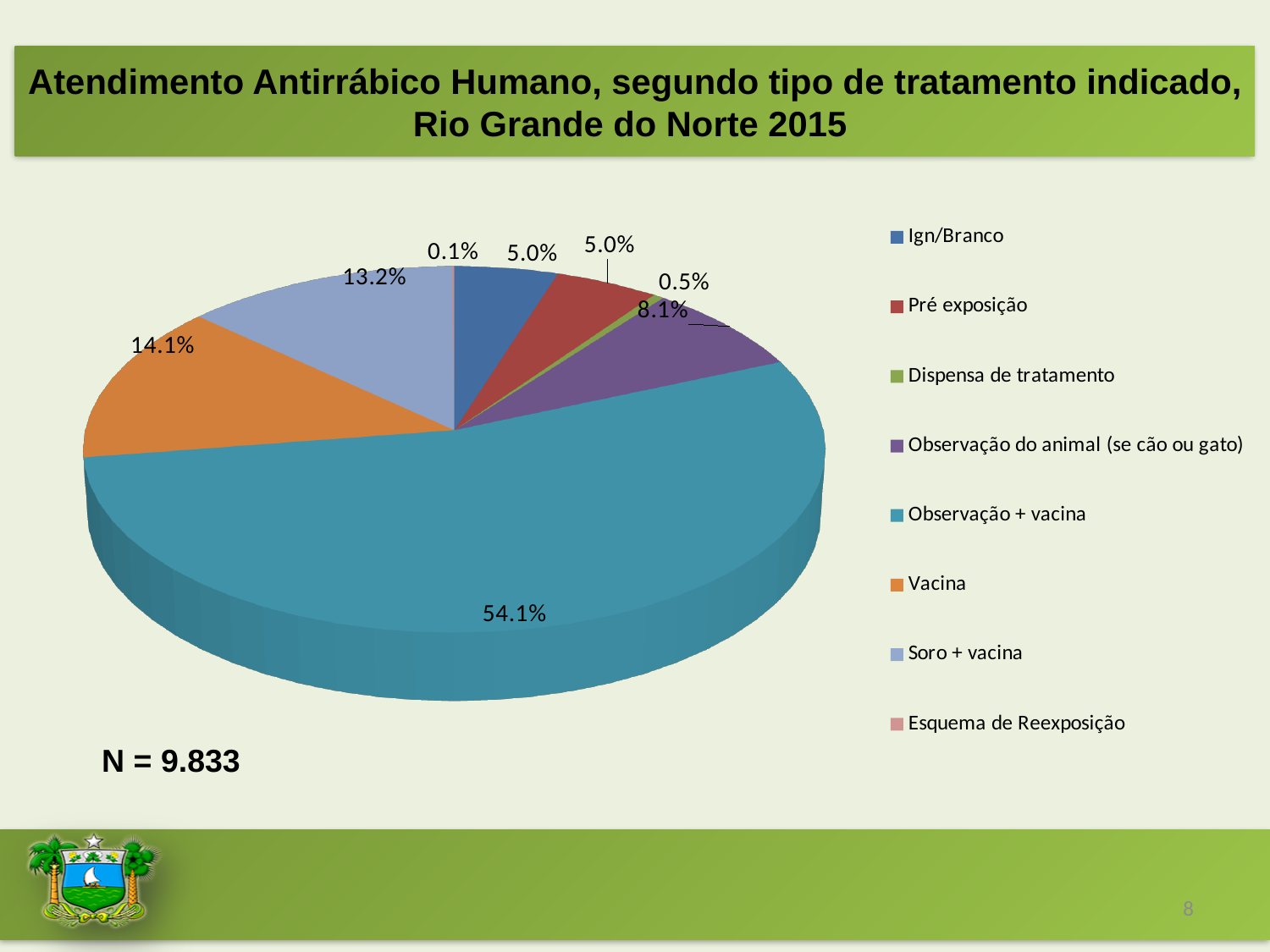
What type of chart is shown on the slide? pie chart What percentage of cases corresponds to Dispensa de tratamento? 0.5% What percentage of cases corresponds to Esquema de Reexposição? 0.1% Which has a larger share, Observação do animal (se cão ou gato) or Pré exposição? Observação do animal (se cão ou gato) What percentage of cases corresponds to Vacina? 14.1% What percentage of cases corresponds to Observação do animal (se cão ou gato)? 8.1% Which treatment type has the largest share of the pie? Observação + vacina How many categories does the legend list? 8 Which treatment type has the smallest share of the pie? Esquema de Reexposição What percentage of cases corresponds to Observação + vacina? 54.1% What is the difference in percentage points between Vacina and Soro + vacina? 0.9 What percentage of cases corresponds to Soro + vacina? 13.2%